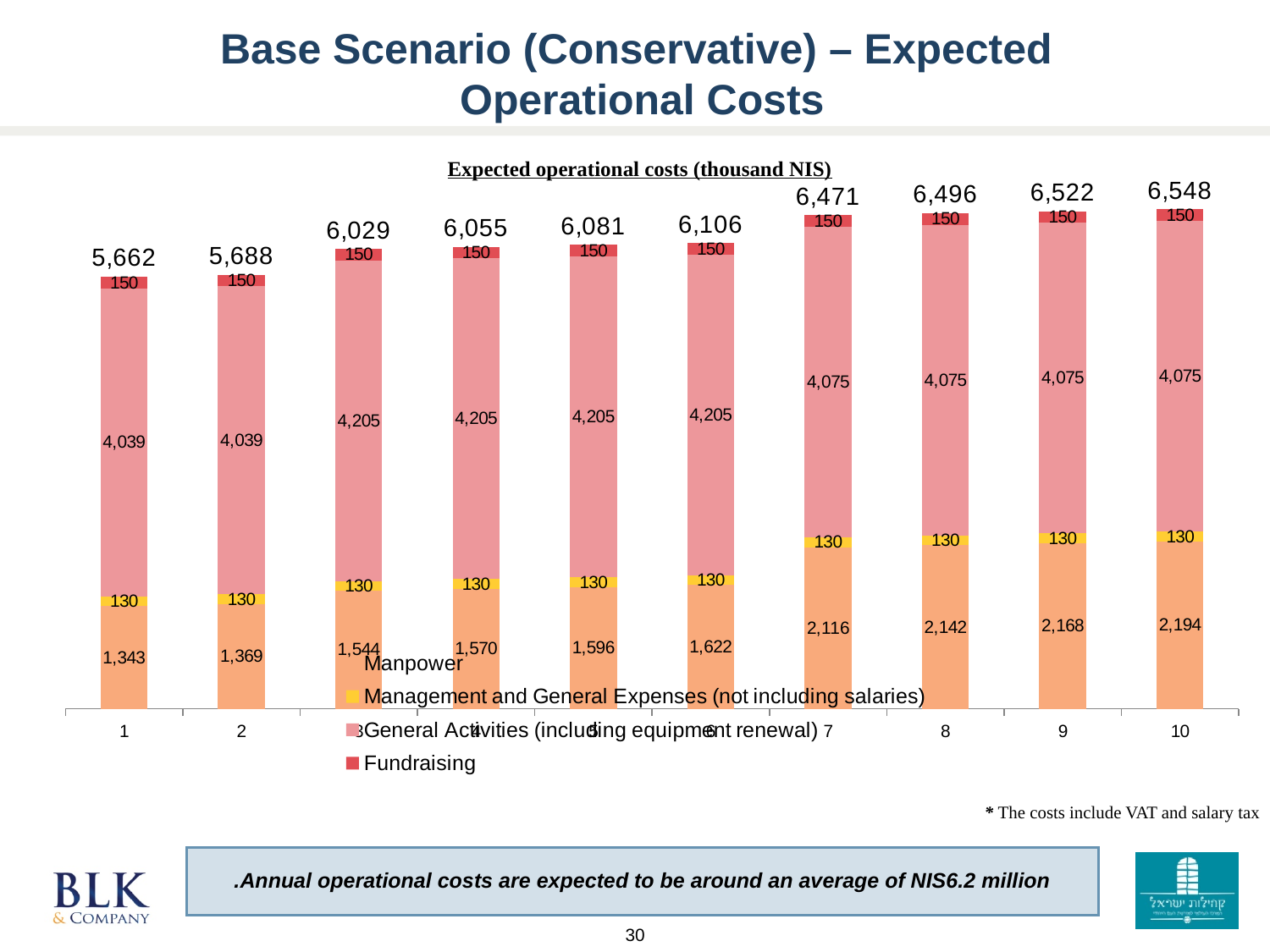
Which year has the highest total expected operational cost? 10 What is the Manpower value for year 10? 2,194 Which year has the lowest total expected operational cost? 1 What is the Fundraising value for year 7? 150 What kind of chart is shown on the slide? Stacked bar chart What is the General Activities (including equipment renewal) value for year 5? 4,205 What is the difference between the total for year 10 and the total for year 1? 886 What is the total expected operational cost shown above the bar for year 1? 5,662 Do the total expected operational costs rise or fall from year 1 to year 10? Rise Which is larger, the Manpower value for year 7 or the Manpower value for year 6? Year 7 How many years (categories) are shown on the x axis? 10 How many series does the legend list? 4